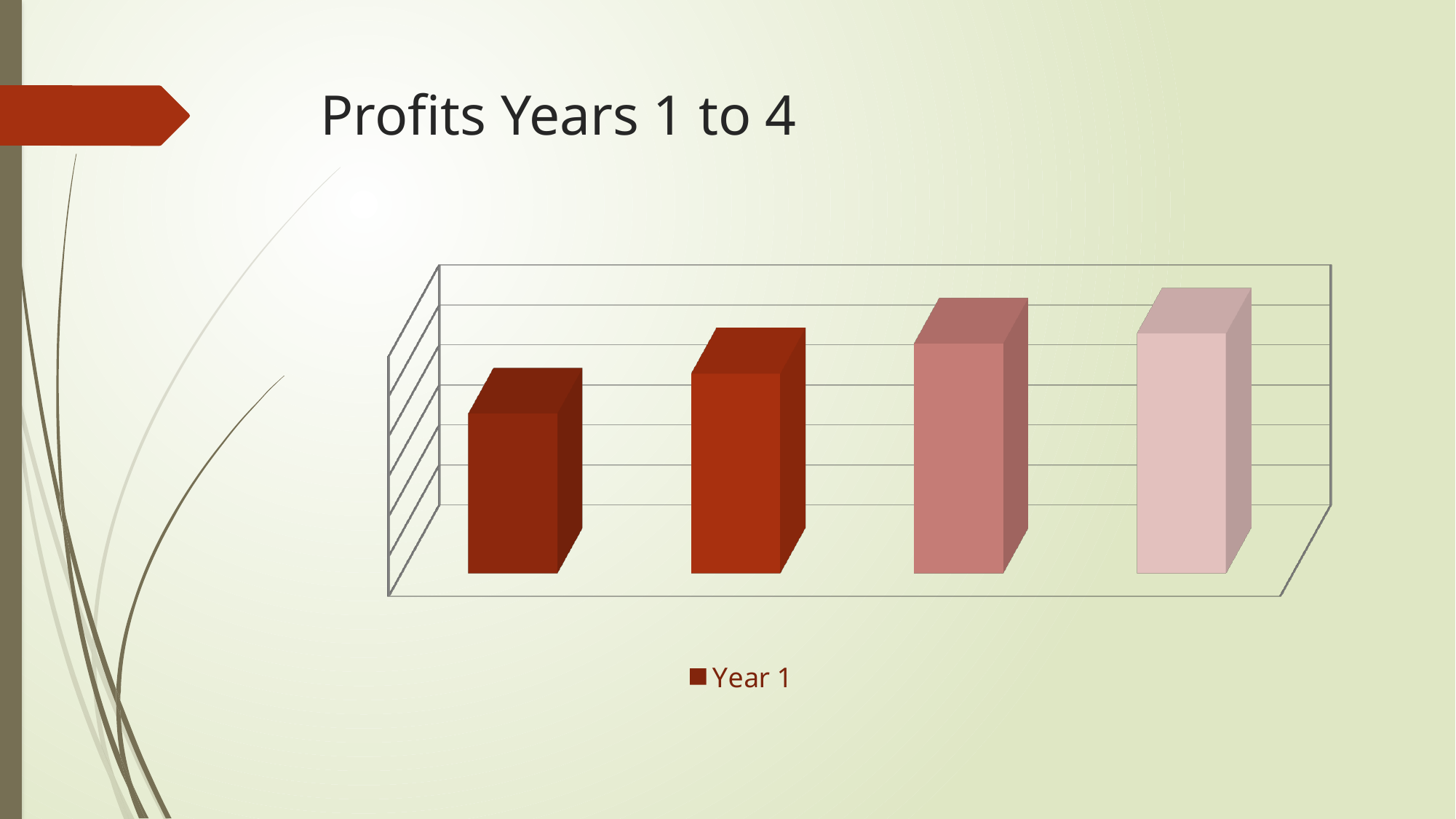
What is the title of the slide containing the chart? Profits Years 1 to 4 Do the bar values rise or fall from left to right across the chart? rise Which is taller, the second bar from the left or the third bar from the left? the third bar How many bars are plotted in the chart? 4 How many series does the chart's legend list? 1 Which bar is the lowest in the chart? the leftmost (first) bar What kind of chart is shown on the slide? bar chart Which bar is the highest in the chart? the rightmost (fourth) bar What entry is shown in the chart's legend? Year 1 Which is taller, the first bar from the left or the second bar from the left? the second bar